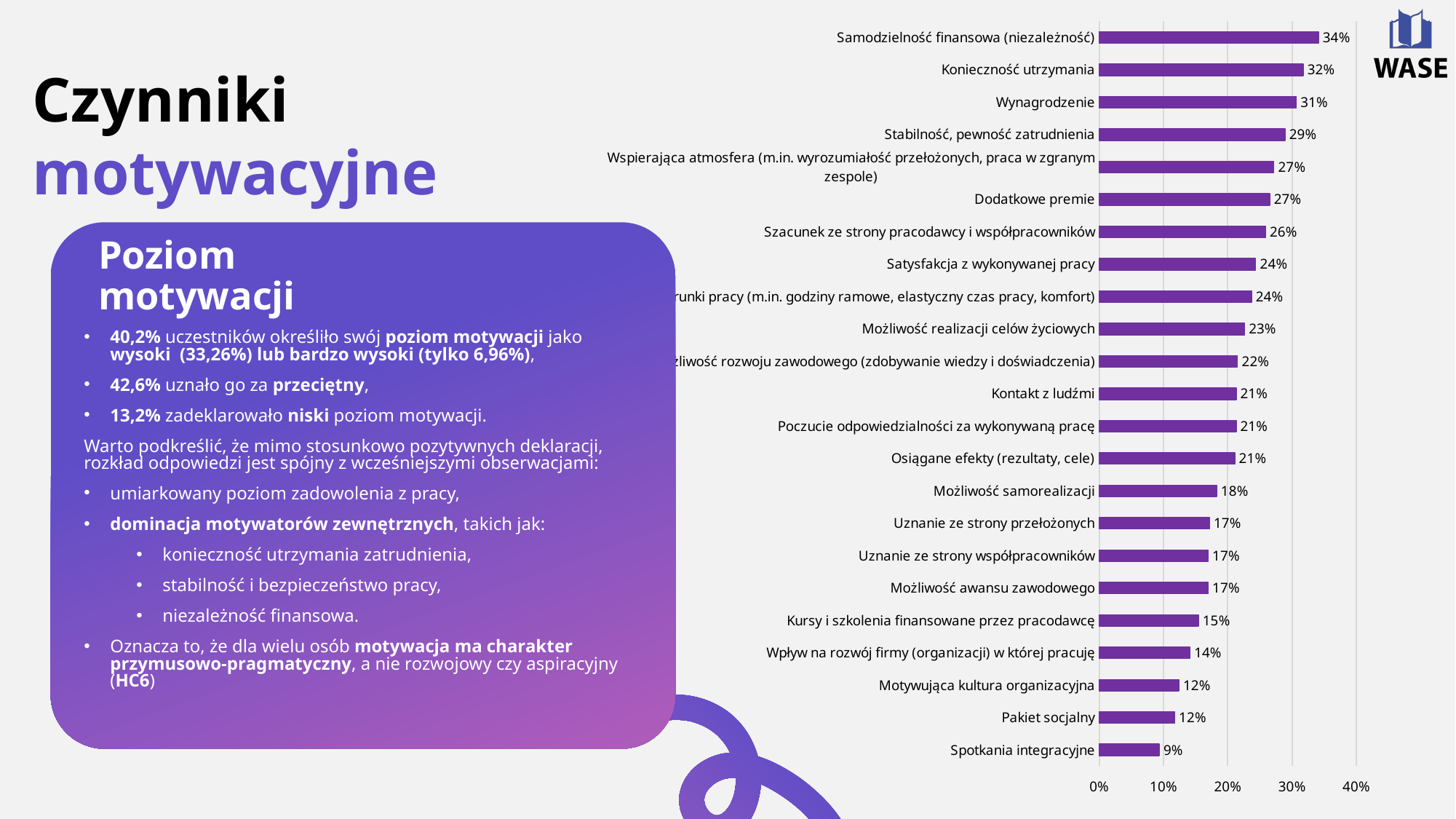
What kind of chart is shown on the slide? bar chart What is the value for Wynagrodzenie? 31% What is the value for Samodzielność finansowa (niezależność)? 34% How many categories are shown in the chart? 23 What is the difference between Konieczność utrzymania and Stabilność, pewność zatrudnienia? 3% What is the highest value shown on the x axis? 40% What is the value for Możliwość samorealizacji? 18% Is the value for Kursy i szkolenia finansowane przez pracodawcę greater or less than 20%? less Which is larger: Dodatkowe premie or Kontakt z ludźmi? Dodatkowe premie What is the value for Pakiet socjalny? 12% Which category has the highest value? Samodzielność finansowa (niezależność) Which category has the lowest value? Spotkania integracyjne